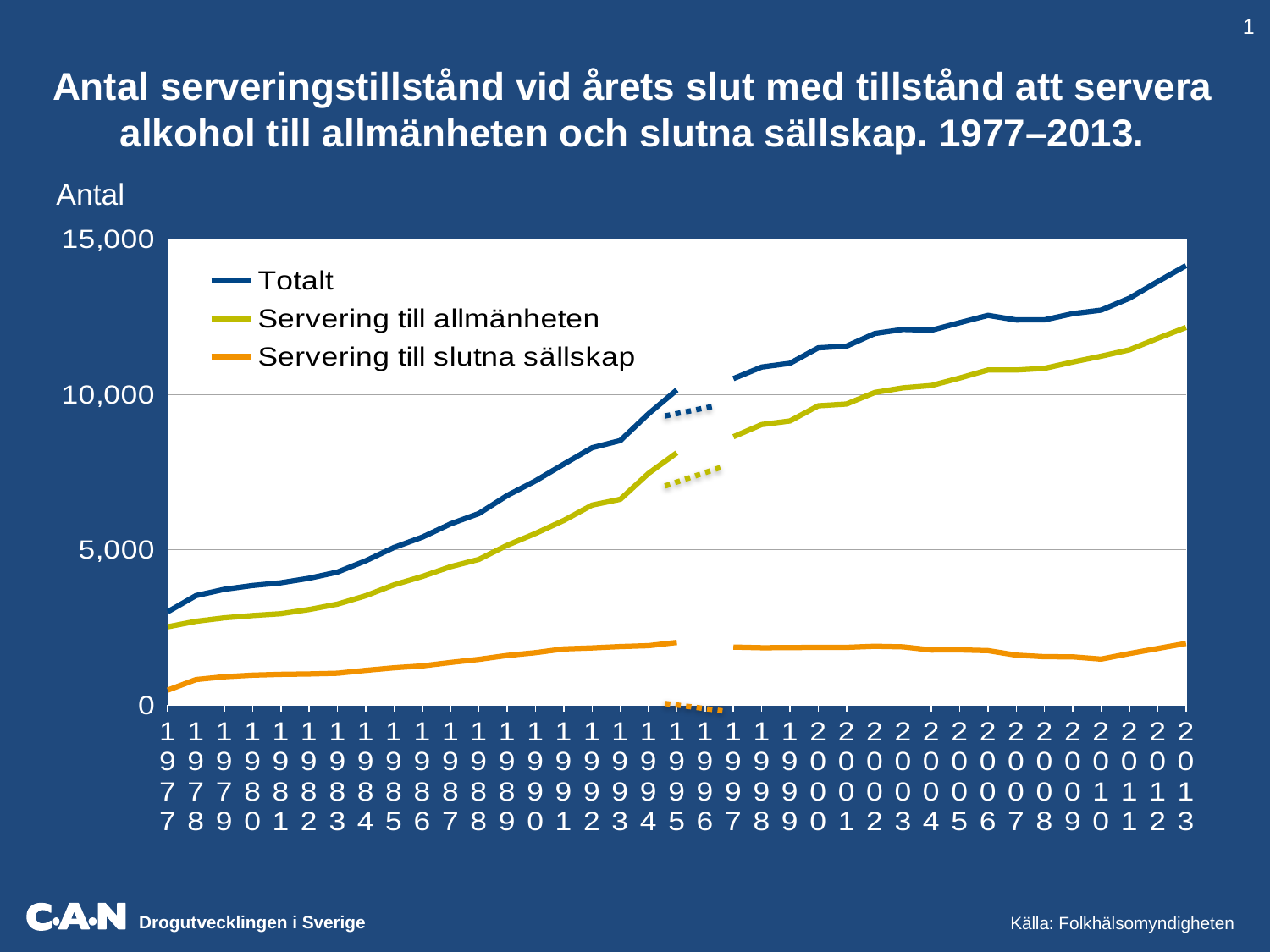
How many series does the legend list? 3 What kind of chart is shown on the slide? Line chart Is the value for Servering till slutna sällskap in 2013 greater or less than 5,000? less Is the value for Servering till allmänheten in 1977 greater or less than 5,000? less How many years are shown along the x axis? 37 Which series has the lowest value in 2013? Servering till slutna sällskap Is the value for Totalt in 2013 greater or less than 10,000? greater What label is shown on the vertical axis? Antal Does the Totalt series rise or fall from 1977 to 2013? Rise Which series has the highest value in 2013? Totalt Which series is drawn in orange? Servering till slutna sällskap Which is larger in 1990, Servering till allmänheten or Servering till slutna sällskap? Servering till allmänheten